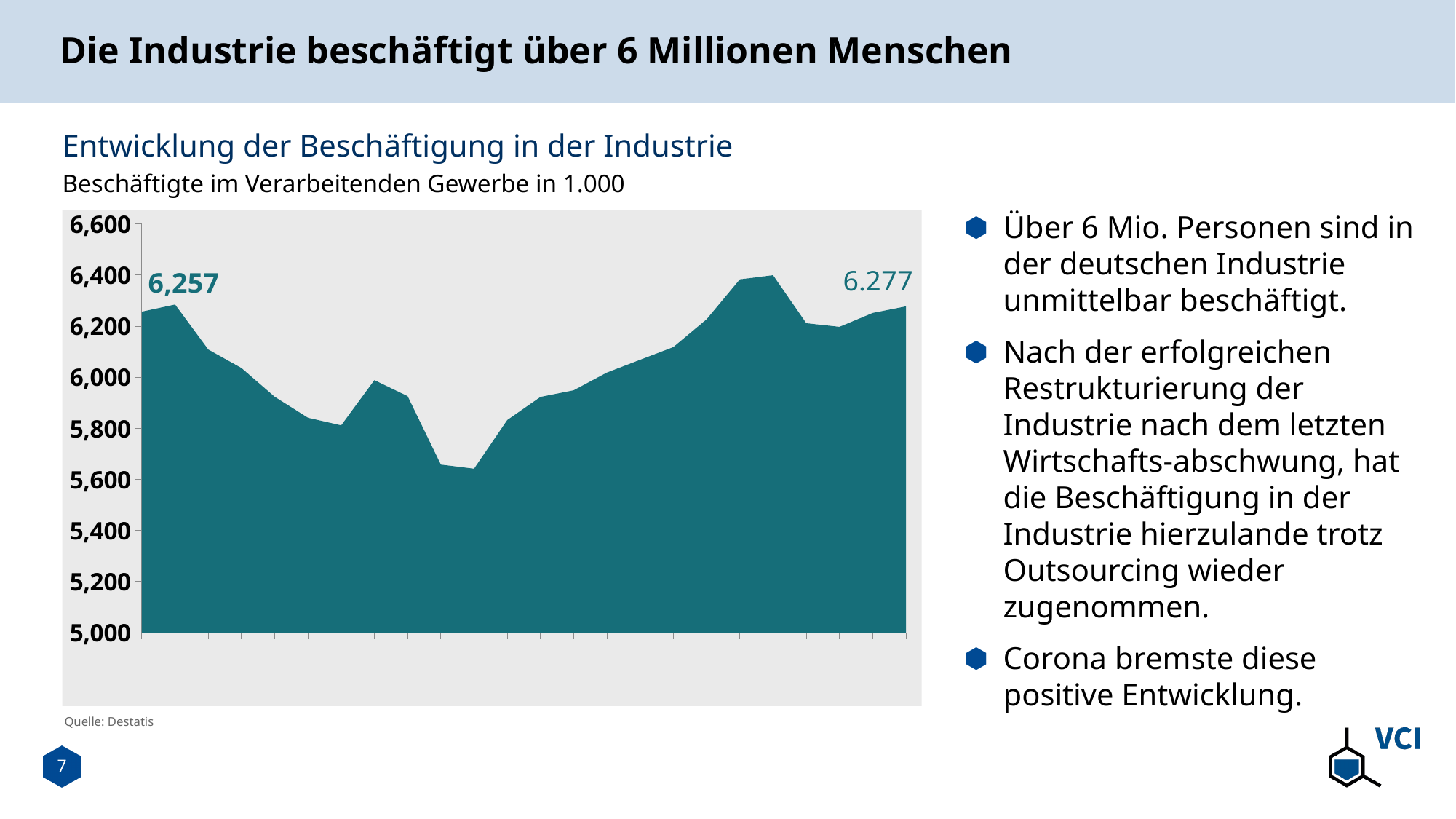
What kind of chart is shown on the slide? area chart Is the highest point of the series greater or less than 6,200? greater Is the lowest point of the series greater or less than 5,800? less What is the difference between the last labelled value (6.277) and the first labelled value (6,257)? 20 Is the first labelled value of the series greater or less than 6,000? greater What is the title of the chart? Entwicklung der Beschäftigung in der Industrie Which is larger, the first labelled value (6,257) or the last labelled value (6.277)? the last value, 6.277 What is the highest value shown on the chart's vertical axis? 6,600 What is the value labelled at the end of the series in the chart? 6.277 What is the value labelled at the start of the series in the chart? 6,257